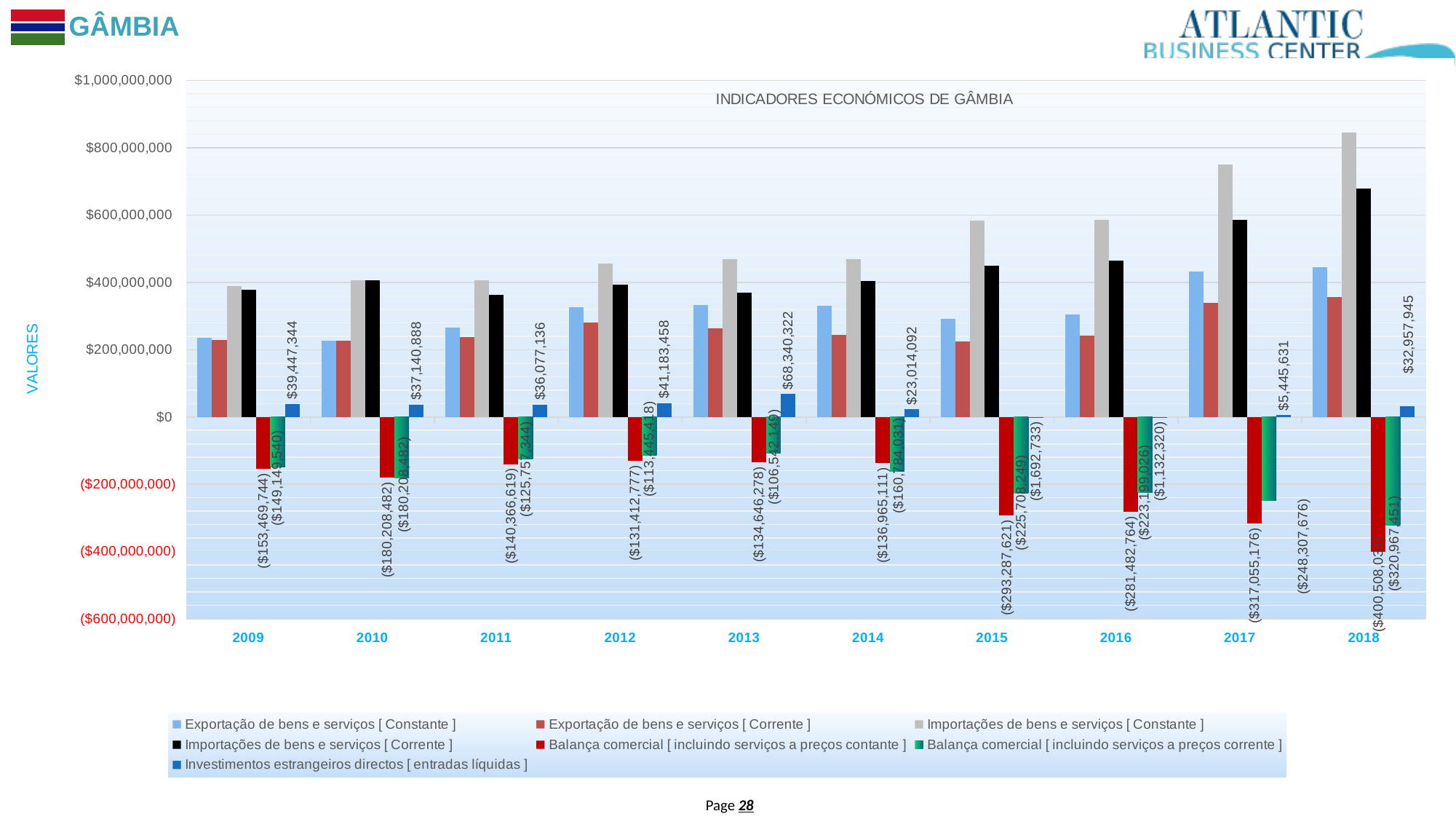
What is the value of Investimentos estrangeiros directos [entradas líquidas] in 2013? $68,340,322 What is the value of Balança comercial [incluindo serviços a preços corrente] in 2017? ($248,307,676) What is the difference between Investimentos estrangeiros directos [entradas líquidas] in 2009 and in 2010? $2,306,456 Which year has the larger value for Exportação de bens e serviços [Constante], 2009 or 2018? 2018 How many series does the legend list? 7 What is the value of Balança comercial [incluindo serviços a preços contante] in 2010? ($180,208,482) In which year is Investimentos estrangeiros directos [entradas líquidas] lowest? 2015 What kind of chart is shown on the slide? Bar chart How many years are shown on the x axis? 10 In which year is Investimentos estrangeiros directos [entradas líquidas] highest? 2013 What is the title of the chart? INDICADORES ECONÓMICOS DE GÂMBIA Is the value for Importações de bens e serviços [Constante] in 2018 greater or less than $800,000,000? greater